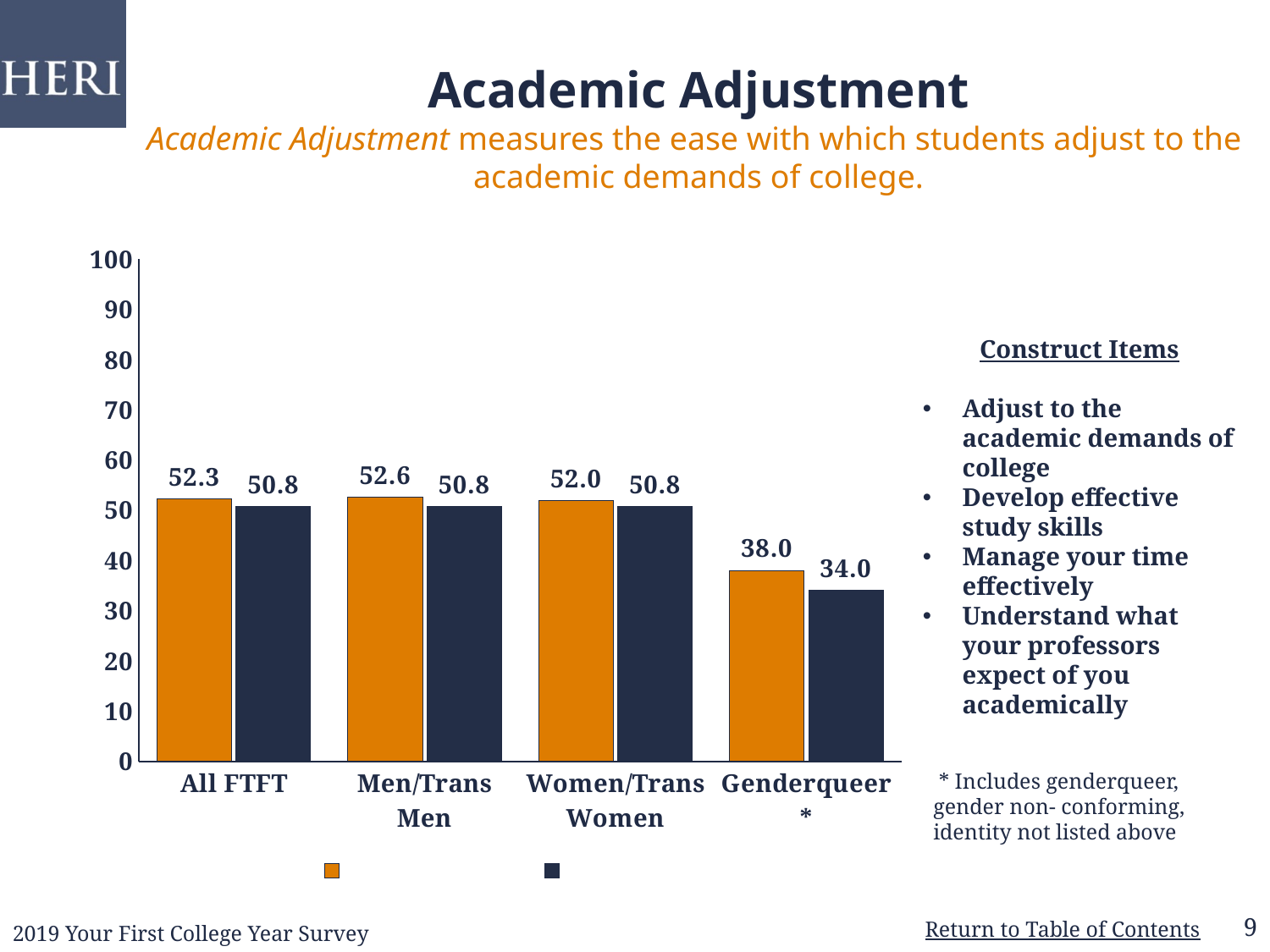
Which category has the lowest orange bar? Genderqueer* Is the orange bar for Genderqueer* greater or less than 40? less How many series does the legend list? 2 What is the value of the dark navy bar for Genderqueer*? 34.0 What kind of chart is shown on the slide? bar chart What is the value of the orange bar for Men/Trans Men? 52.6 Which category has the highest orange bar? Men/Trans Men Which is larger for Women/Trans Women, the orange bar or the dark navy bar? the orange bar What is the difference between the orange bar for Men/Trans Men and the orange bar for Women/Trans Women? 0.6 What is the difference between the orange and dark navy bars for Genderqueer*? 4.0 How many categories are shown on the x axis? 4 What is the value of the orange bar for All FTFT? 52.3